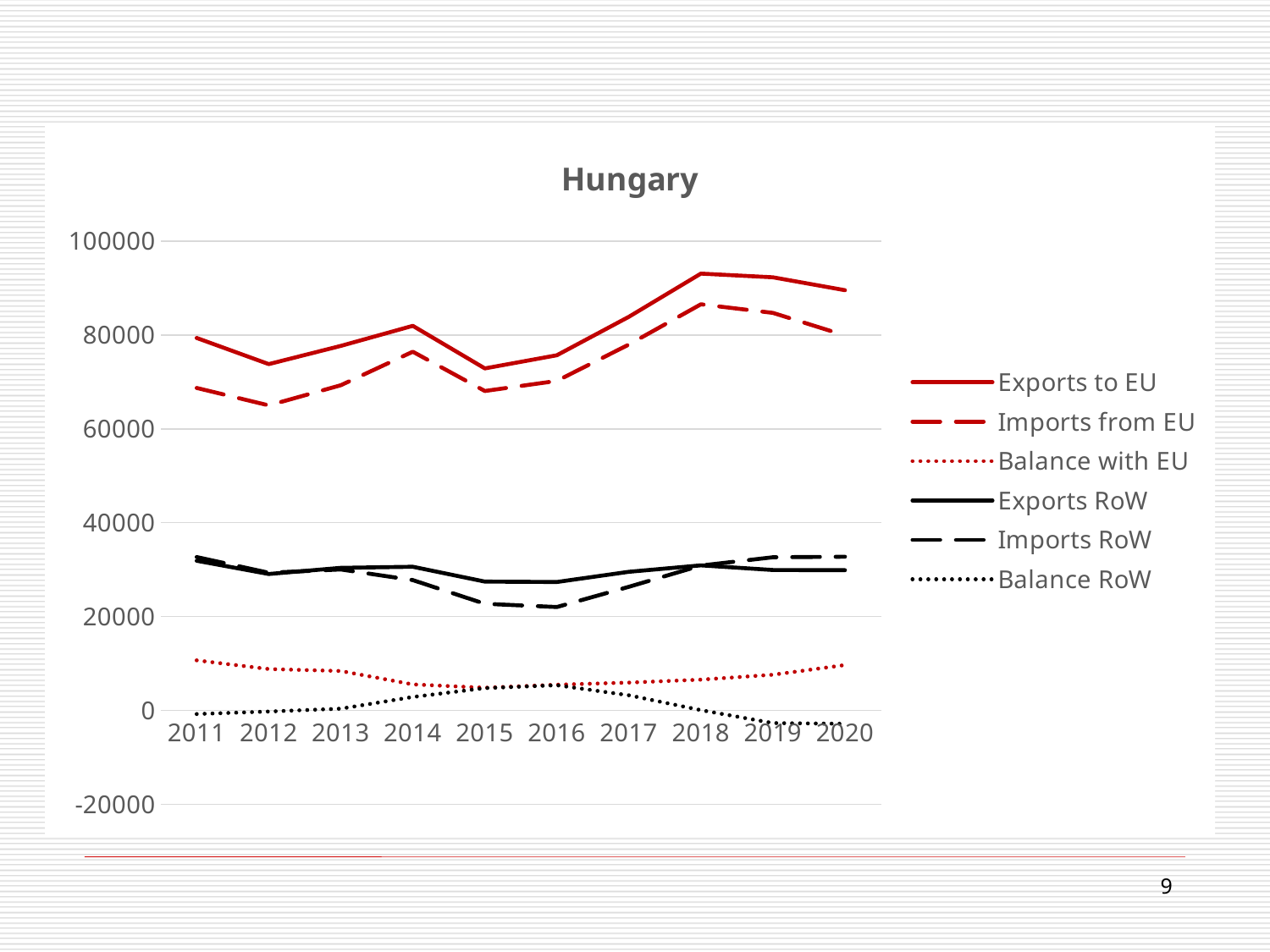
How many years are shown on the x axis? 10 In which year is Balance with EU highest? 2011 Is the value for Balance RoW in 2020 greater or less than 0? less Is the value for Exports to EU in 2018 greater or less than 90000? greater How many series does the legend list? 6 In 2020, which is larger: Exports to EU or Imports from EU? Exports to EU Is the value for Imports RoW in 2016 greater or less than 25000? less Does Balance with EU rise or fall from 2011 to 2015? fall In which year is Imports from EU lowest? 2012 What kind of chart is shown on the slide? line chart What is the title of the chart? Hungary In which year is Exports to EU highest? 2018